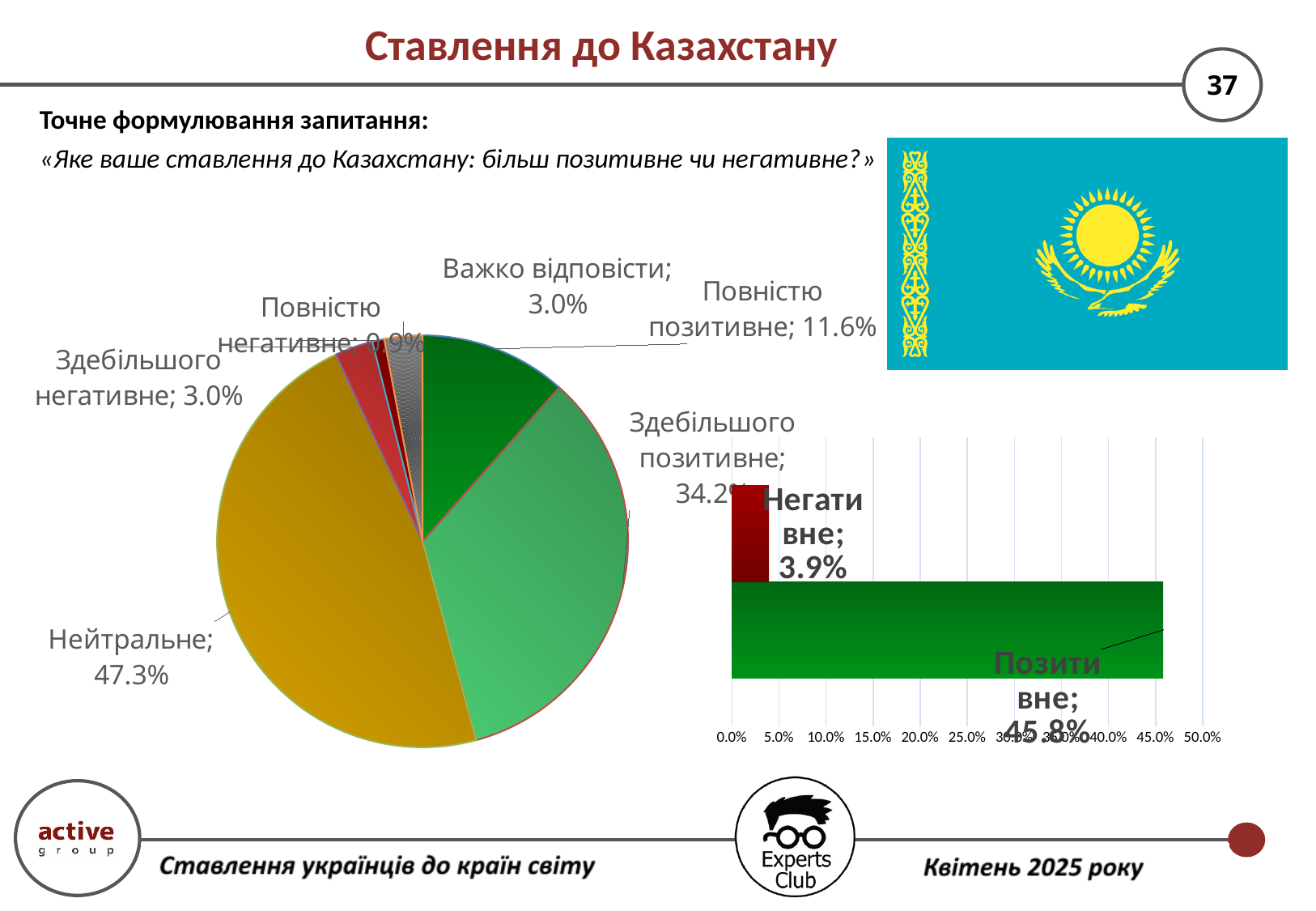
What kind of chart is on the right side of the slide? bar chart In the pie chart, what is the share for Нейтральне? 47.3% In the pie chart, which category has the largest share? Нейтральне In the pie chart, what is the share for Повністю негативне? 0.9% In the bar chart, what is the value for Негативне? 3.9% In the pie chart, what is the share for Повністю позитивне? 11.6% In the pie chart, what is the difference between Повністю позитивне and Здебільшого негативне? 8.6% What kind of chart is on the left side of the slide? pie chart In the pie chart, what is the share for Важко відповісти? 3.0% In the bar chart, what is the difference between Позитивне and Негативне? 41.9% In the bar chart, what is the value for Позитивне? 45.8% In the pie chart, which category has the smallest share? Повністю негативне